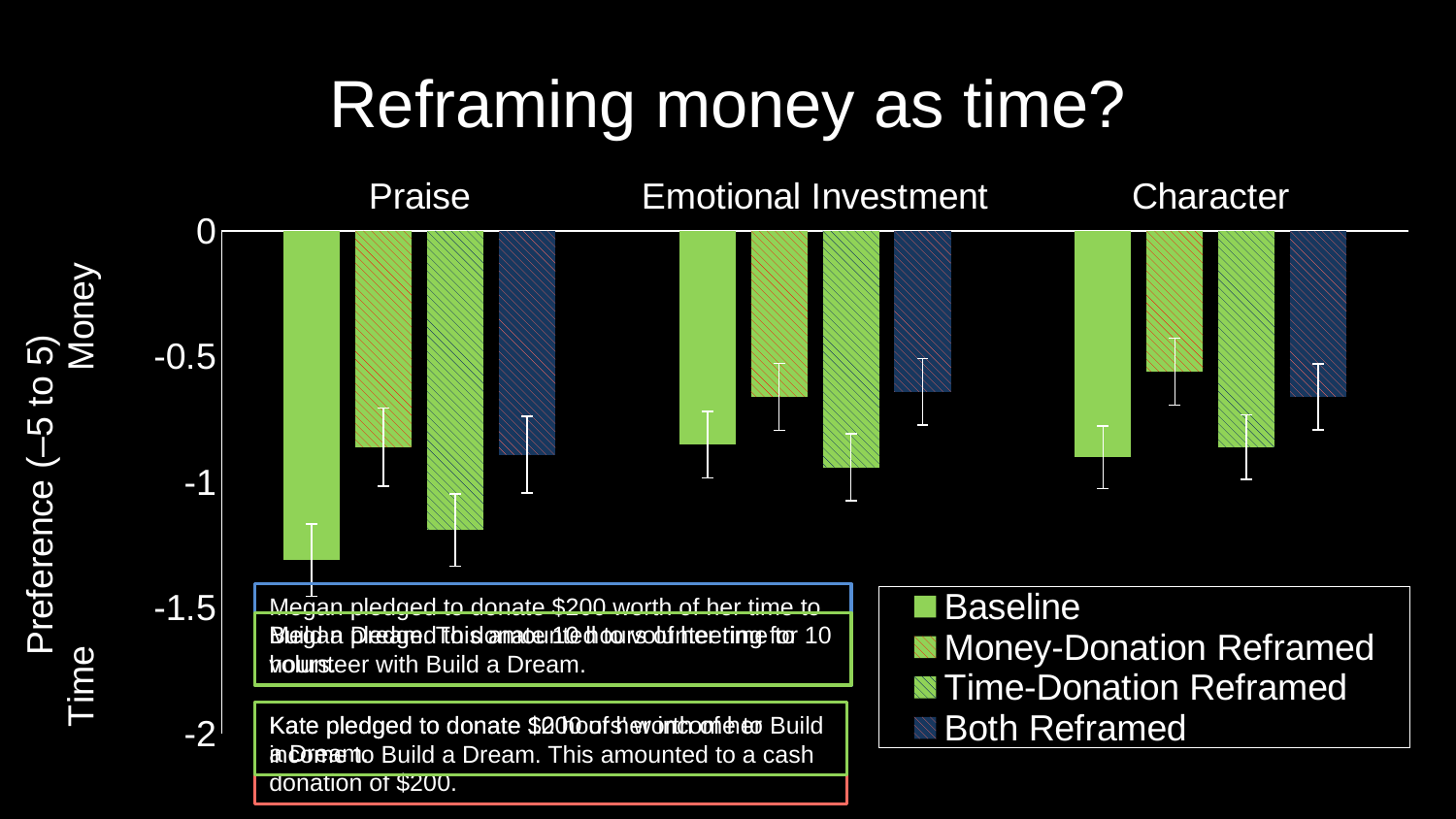
Which series has the lowest value in the Praise group? Baseline What is the title of the chart? Reframing money as time? How many series does the legend list? 4 How many category groups are shown along the x axis? 3 Is the Baseline value for Praise greater or less than -1? less What is the label on the y axis? Preference (–5 to 5) Is the Time-Donation Reframed value for Praise greater or less than -1? less Is the Money-Donation Reframed value for Emotional Investment greater or less than -1? greater Which series has the highest value in the Character group? Money-Donation Reframed Which is larger, the Baseline value for Praise or the Money-Donation Reframed value for Praise? Money-Donation Reframed What kind of chart is shown on the slide? bar chart